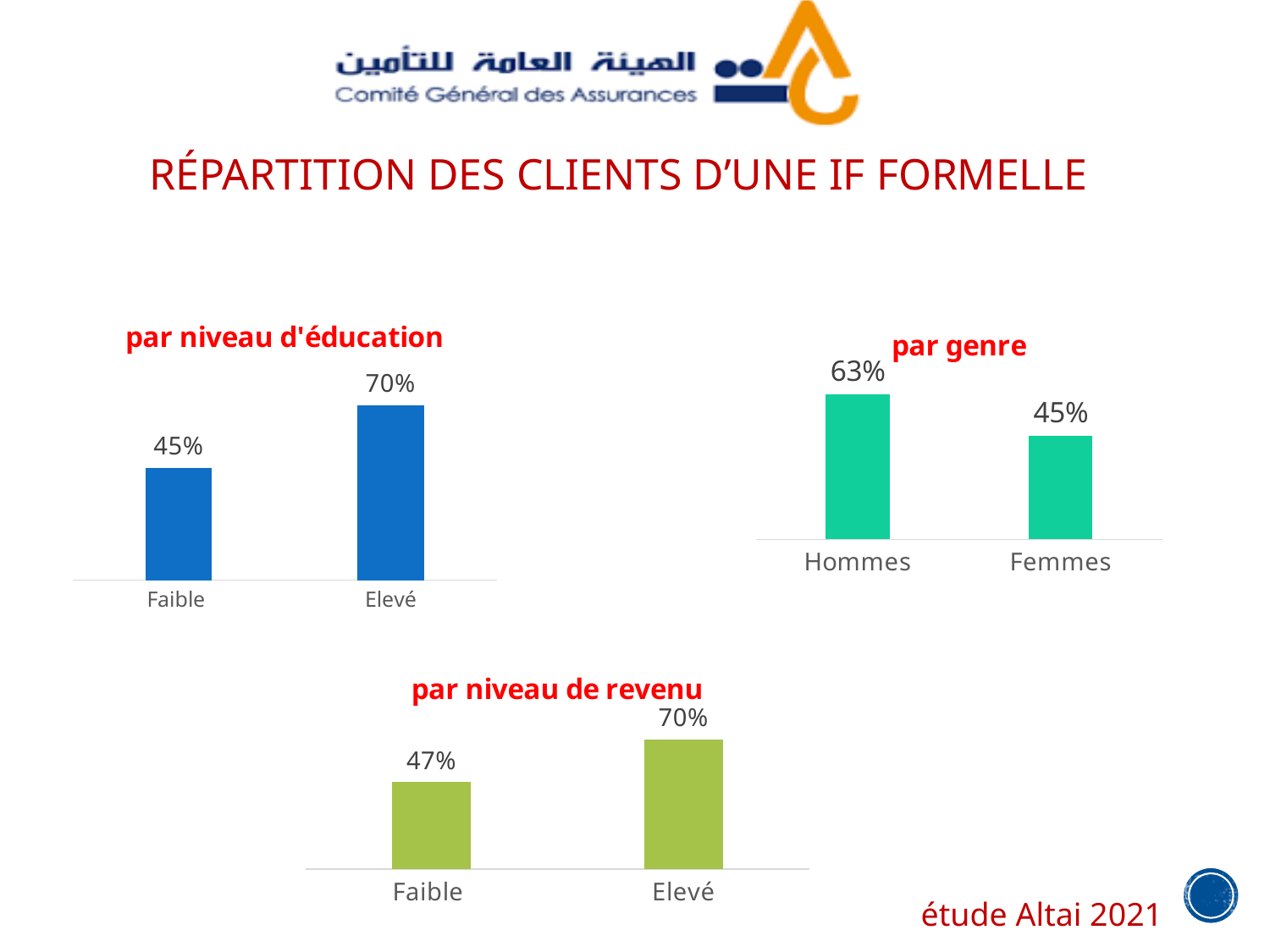
In the 'par niveau d'éducation' chart, what is the value for Elevé? 70% In the 'par genre' chart, what is the value for Hommes? 63% How many categories does the 'par genre' chart show? 2 In the 'par niveau de revenu' chart, what is the value for Faible? 47% In the 'par niveau de revenu' chart, which is larger, Faible or Elevé? Elevé In the 'par genre' chart, which category has the lowest value? Femmes In the 'par genre' chart, what is the value for Femmes? 45% In the 'par niveau d'éducation' chart, what is the difference between Elevé and Faible? 25% In the 'par niveau de revenu' chart, which category has the highest value? Elevé In the 'par niveau d'éducation' chart, what is the value for Faible? 45% In the 'par genre' chart, what is the difference between Hommes and Femmes? 18% What type of chart is the 'par niveau de revenu' chart? Bar chart